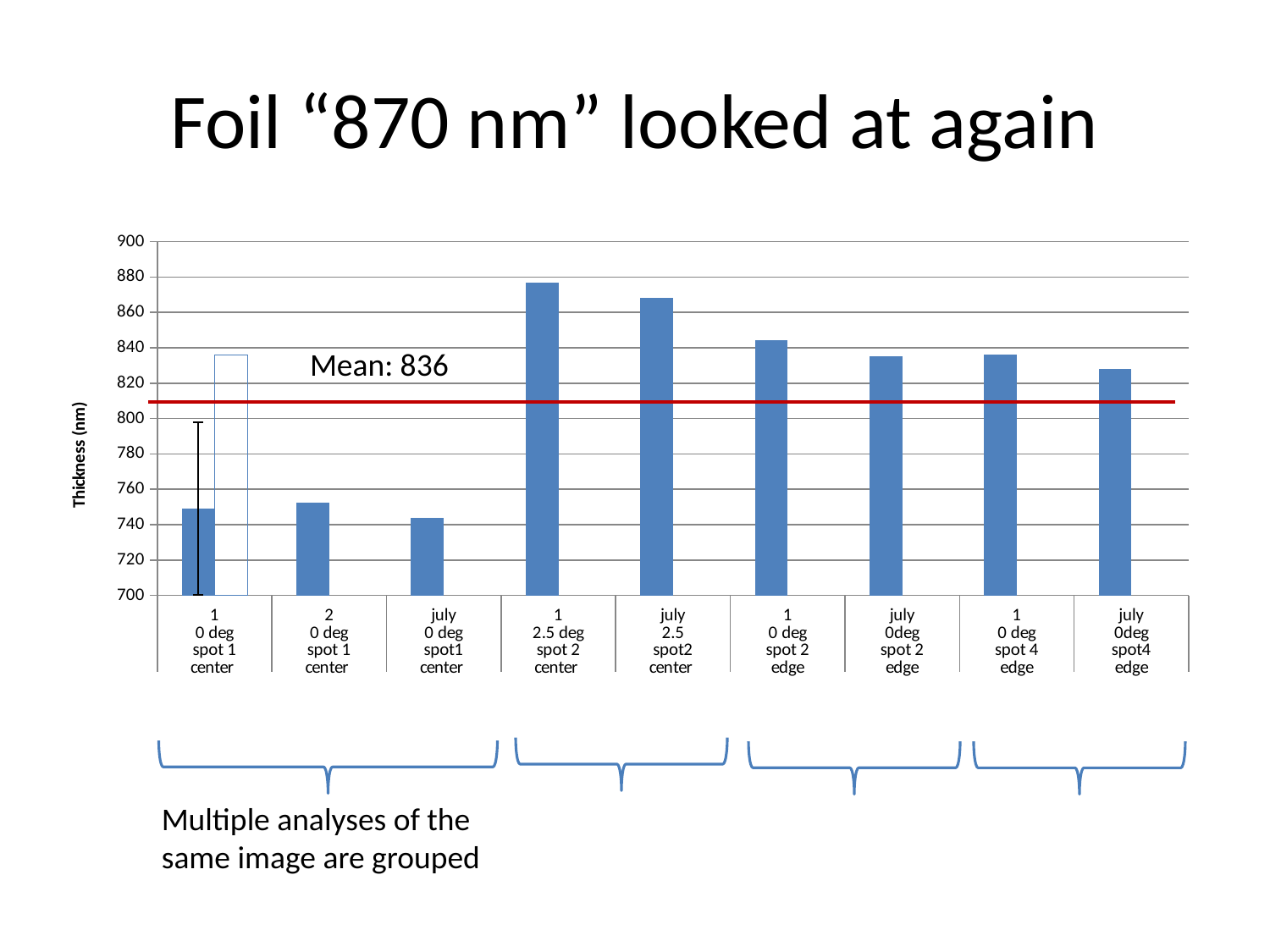
Is the thickness for '1 2.5 deg spot 2 center' greater or less than 860? greater Which is larger: the thickness for '2 0 deg spot 1 center' or for '1 2.5 deg spot 2 center'? 1 2.5 deg spot 2 center Is the thickness for 'july 0deg spot4 edge' greater or less than 840? less Which is larger: the thickness for '1 2.5 deg spot 2 center' or for 'july 2.5 spot2 center'? 1 2.5 deg spot 2 center Which category has the highest thickness in the chart? 1 2.5 deg spot 2 center Is the thickness for 'july 2.5 spot2 center' greater or less than 860? greater How many bars (categories) are plotted in the chart? 9 What kind of chart is shown on the slide? bar chart What is the label of the vertical axis? Thickness (nm) What mean value is annotated on the chart? 836